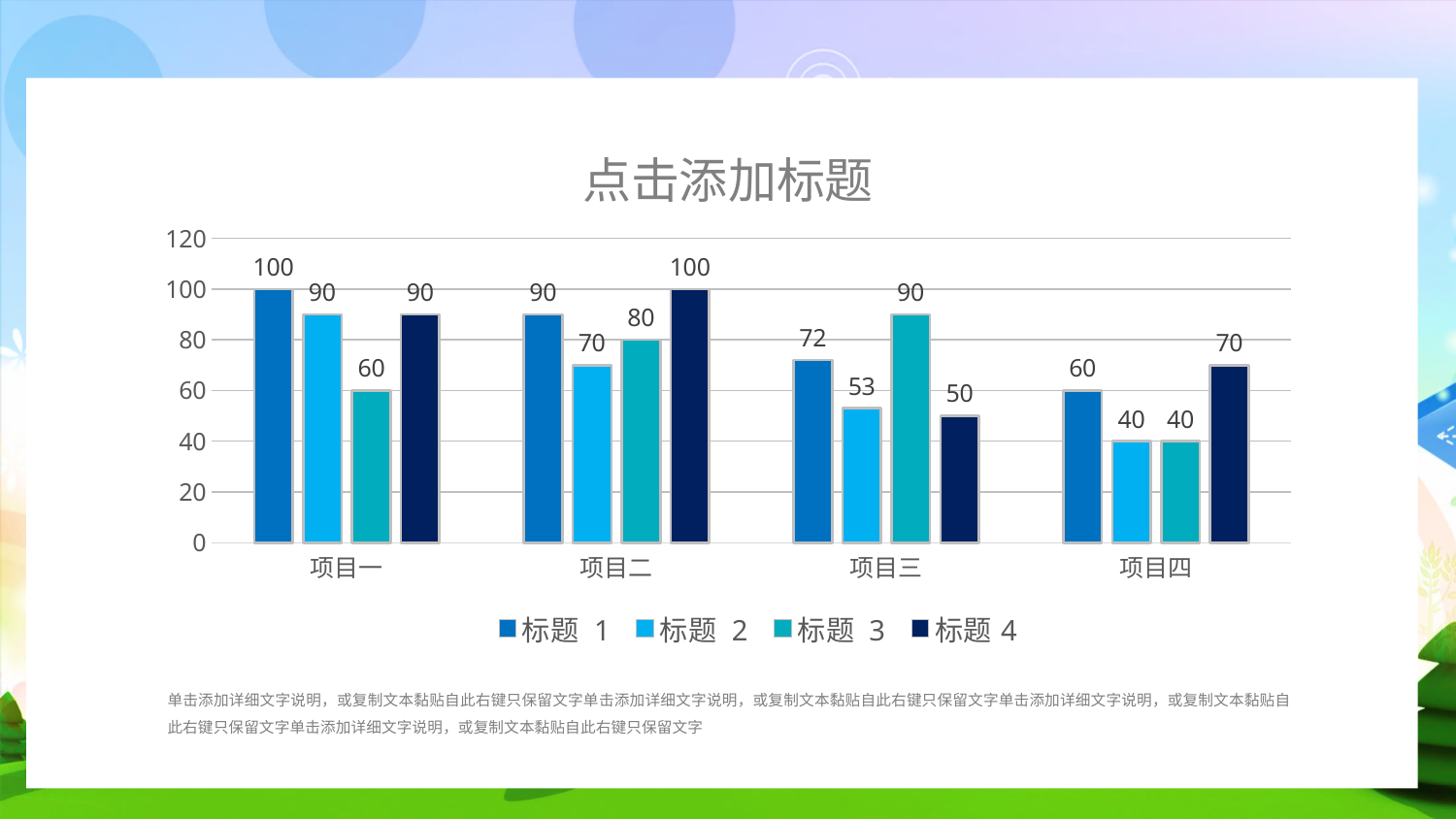
What is the value of 标题 3 for 项目二? 80 Which is larger for 项目四: the value of 标题 1 or the value of 标题 4? 标题 4 What kind of chart is shown on the slide? Bar chart What is the value of 标题 4 for 项目四? 70 What is the difference between the 标题 1 value and the 标题 2 value for 项目三? 19 Do the values of 标题 2 rise or fall from 项目一 to 项目四? Fall What is the value of 标题 2 for 项目三? 53 How many categories are shown on the x axis? 4 Which series has the lowest value for 项目三? 标题 4 Which series has the highest value for 项目二? 标题 4 What is the value of 标题 1 for 项目一? 100 How many series does the legend list? 4